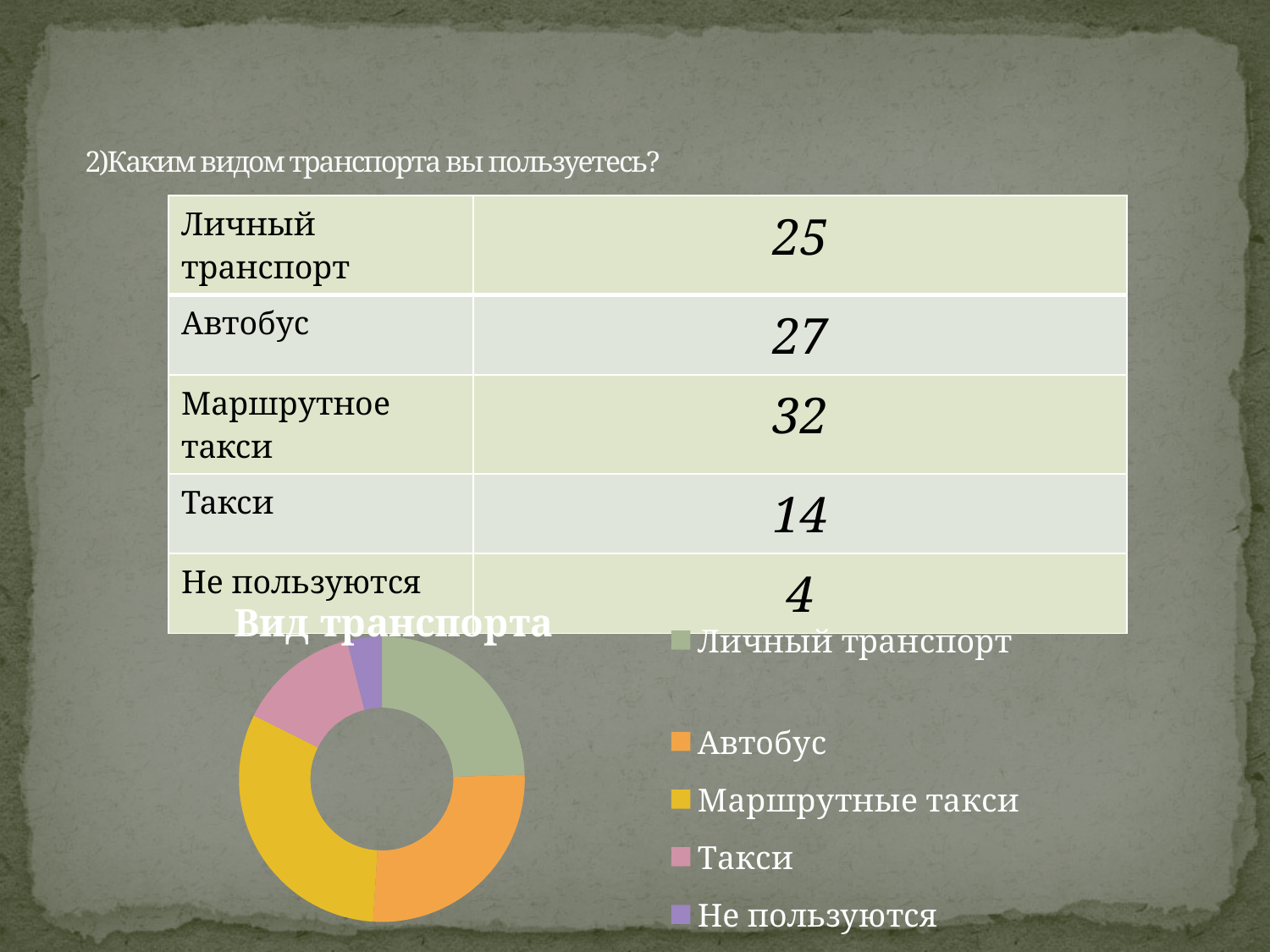
According to the table on the slide, which type of transport has the highest value? Маршрутное такси What kind of chart is shown on the slide? Doughnut (pie) chart According to the table on the slide, what is the value for Не пользуются? 4 According to the table on the slide, what is the value for Личный транспорт? 25 How many categories does the chart's legend list? 5 According to the table on the slide, what is the value for Автобус? 27 According to the table on the slide, what is the value for Такси? 14 Using the table values, what is the difference between Маршрутное такси and Такси? 18 Which colour represents Такси in the chart's legend? Pink What is the title of the chart? Вид транспорта Which is larger in the chart, the slice for Автобус or the slice for Такси? Автобус Which category has the smallest slice in the chart? Не пользуются